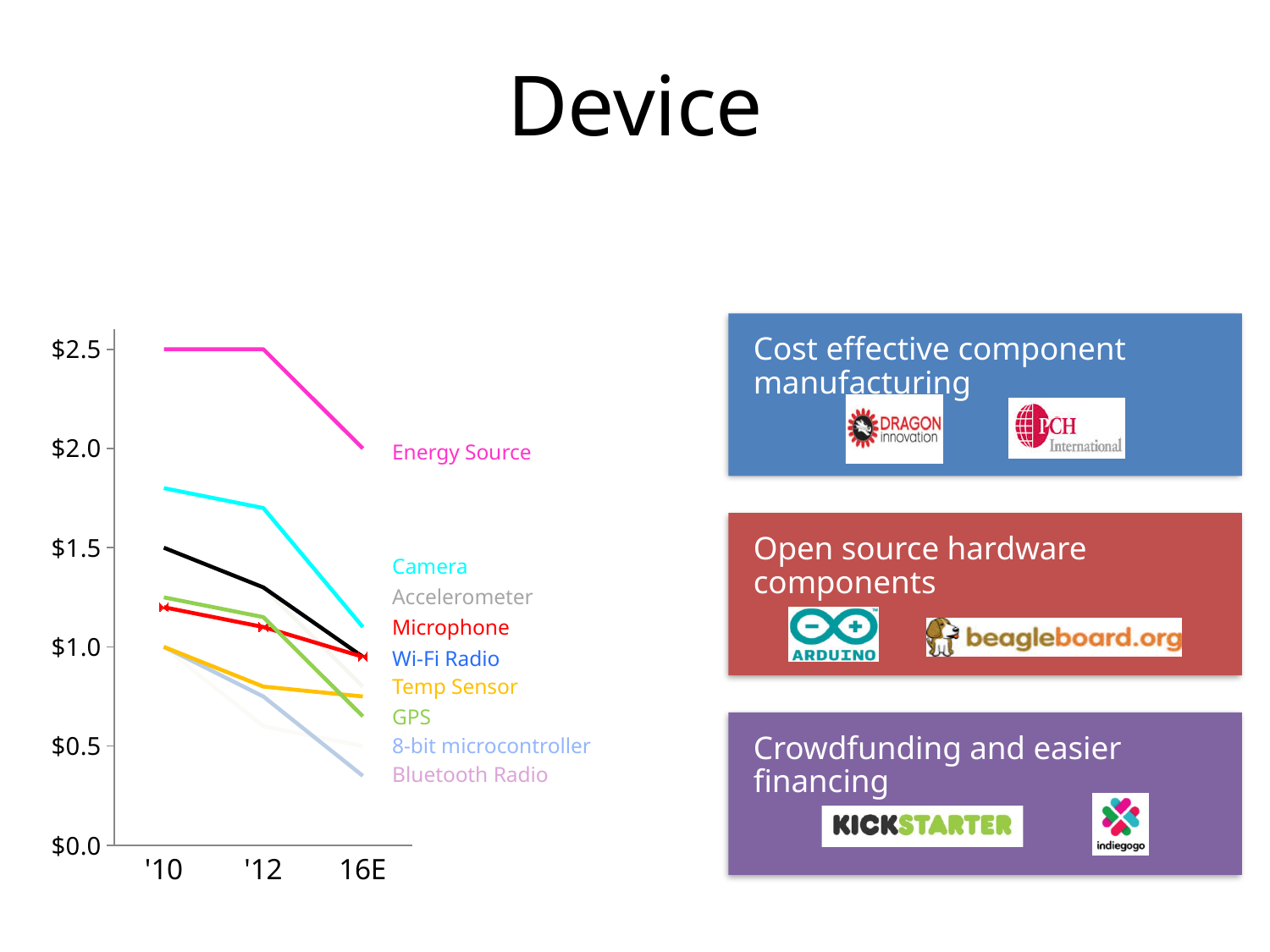
What is the value for Accelerometer in '10? $1.5 Which series has the highest value in '10? Energy Source What is the value for Energy Source in '10? $2.5 How many series does the chart's legend list? 9 Does the Energy Source line rise or fall from '10 to 16E? fall By how much does the Energy Source value fall from '10 to 16E? $0.5 What is the value for Energy Source in 16E? $2.0 What kind of chart is shown on the left of the slide? line chart Is the value for Camera in '10 greater or less than $1.5? greater How many points are on the x axis of the chart? 3 Which is larger in '10, Camera or Accelerometer? Camera Is the value for GPS in 16E greater or less than $1.0? less